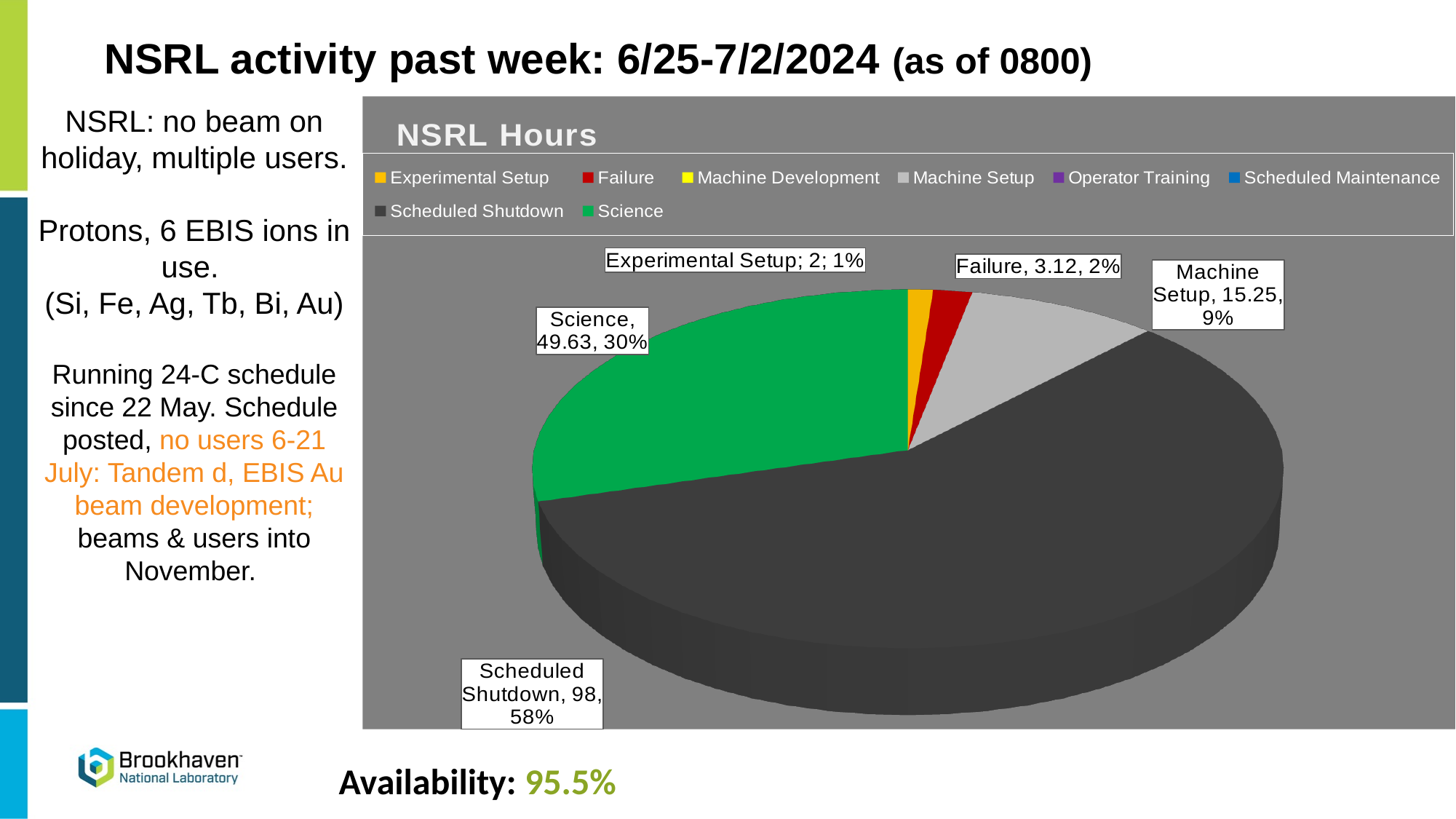
What kind of chart is shown on the slide? pie chart Which category has the largest slice of the pie? Scheduled Shutdown How many hours are shown for Science? 49.63 What percentage share of the pie does Scheduled Shutdown have? 58% What is the difference in hours between Scheduled Shutdown and Science? 48.37 What percentage share of the pie does Science have? 30% Which labeled category has the smallest slice of the pie? Experimental Setup How many hours are shown for Scheduled Shutdown? 98 How many entries does the legend list? 8 What is the title of the chart? NSRL Hours How many hours are shown for Failure? 3.12 How many hours are shown for Machine Setup? 15.25